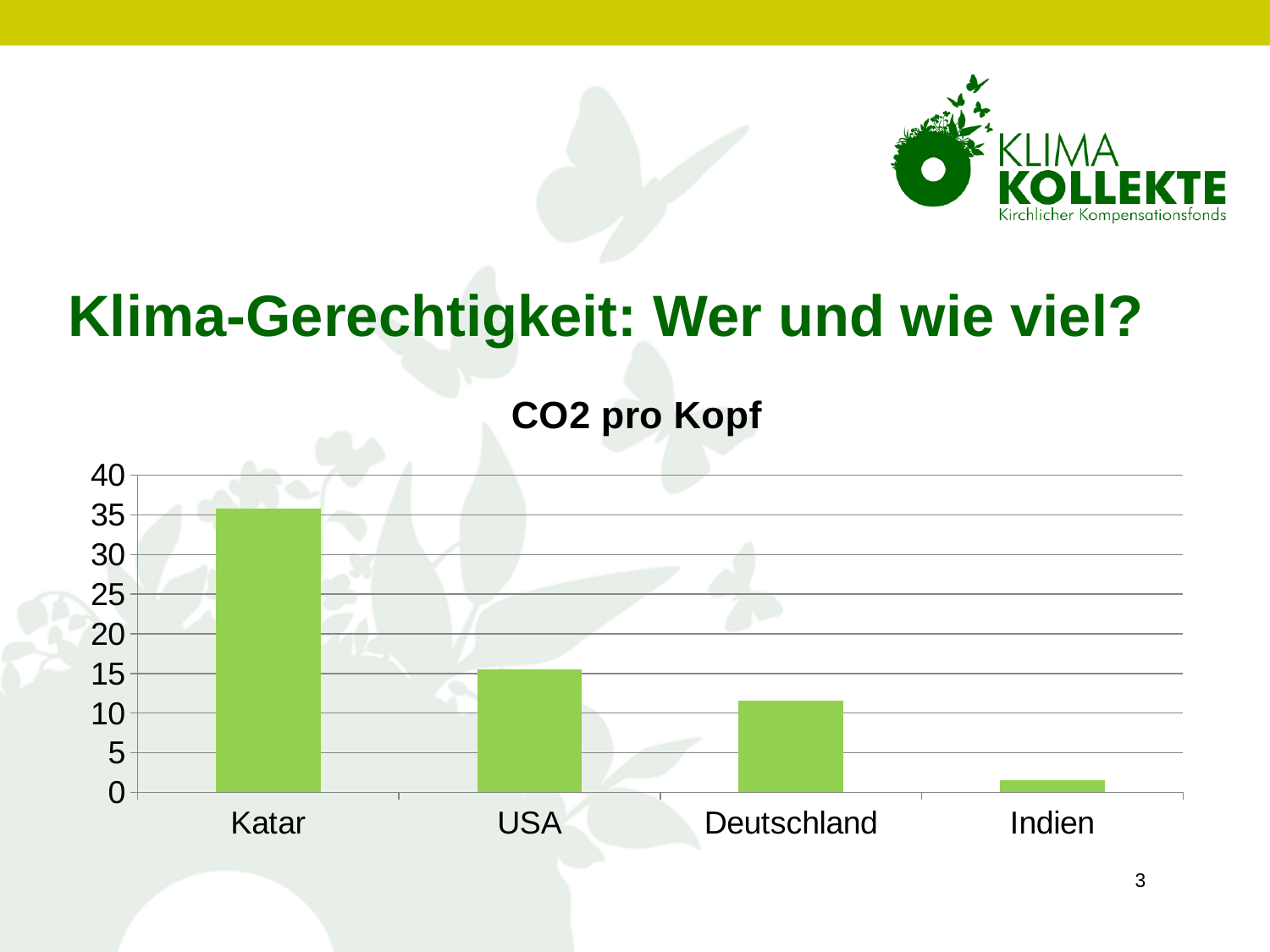
What is the title of the chart? CO2 pro Kopf Is the value for Katar greater or less than 30? greater How many countries are shown on the x axis of the chart? 4 Which country has the lowest CO2 pro Kopf value? Indien Is the value for USA greater or less than 20? less Which has a larger value, Deutschland or Indien? Deutschland Is the value for Indien greater or less than 5? less Which has a larger value, USA or Deutschland? USA What kind of chart is shown on the slide? bar chart Do the values rise or fall from left to right along the x axis? fall Which country has the highest CO2 pro Kopf value? Katar